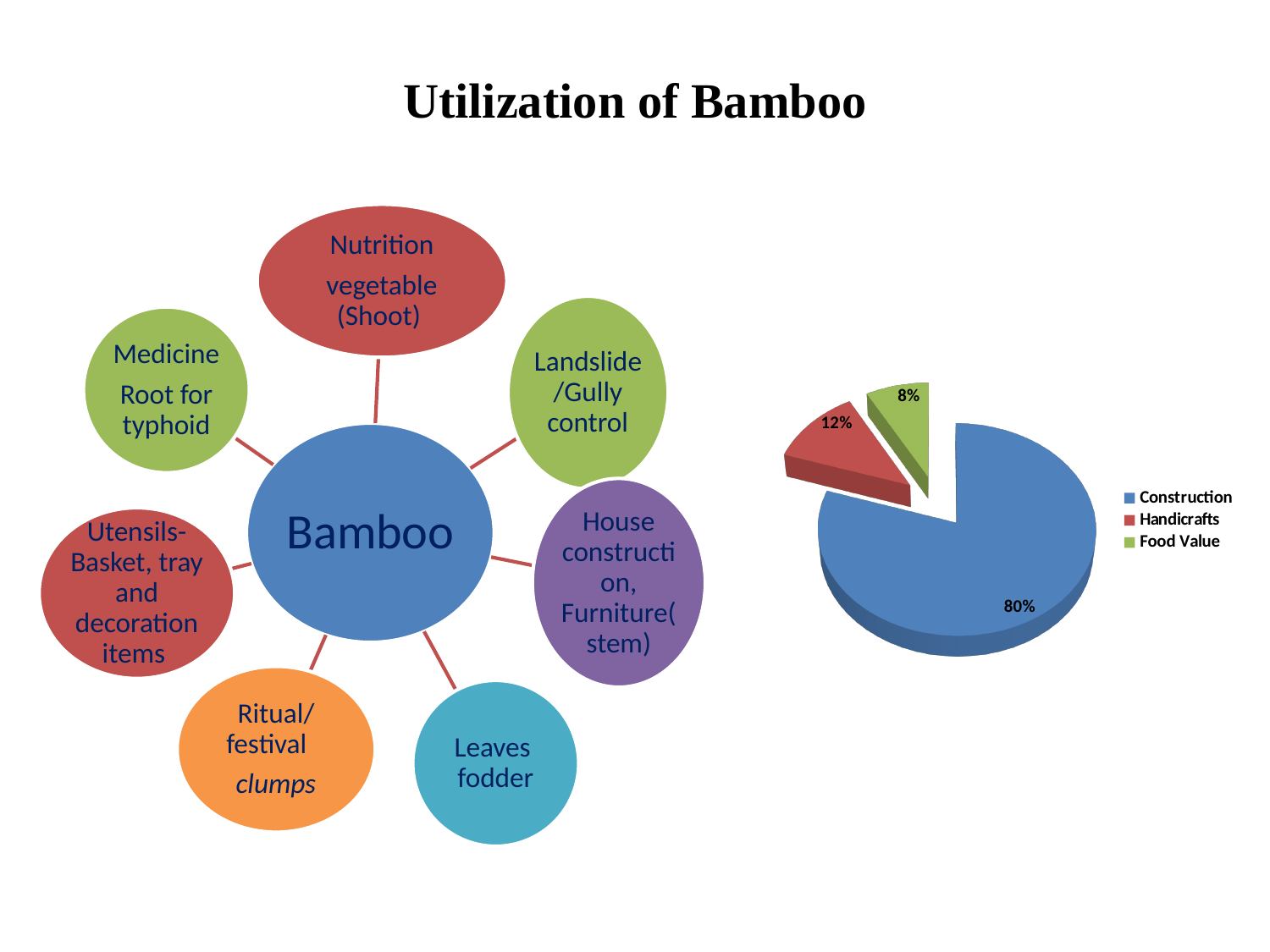
How many categories does the pie chart show? 3 Which category has the smallest slice in the pie chart? Food Value What is the difference in percentage points between the Construction and Handicrafts slices? 68% What share of the pie chart does Construction account for? 80% What share of the pie chart does Handicrafts account for? 12% What kind of chart is shown on the right of the slide? Pie chart Which category has the largest slice in the pie chart? Construction What share of the pie chart does Food Value account for? 8% Which is larger in the pie chart, Handicrafts or Food Value? Handicrafts What colour is the Construction slice in the pie chart? Blue What is the difference in percentage points between the Handicrafts and Food Value slices? 4% Which category is shown in green in the pie chart legend? Food Value